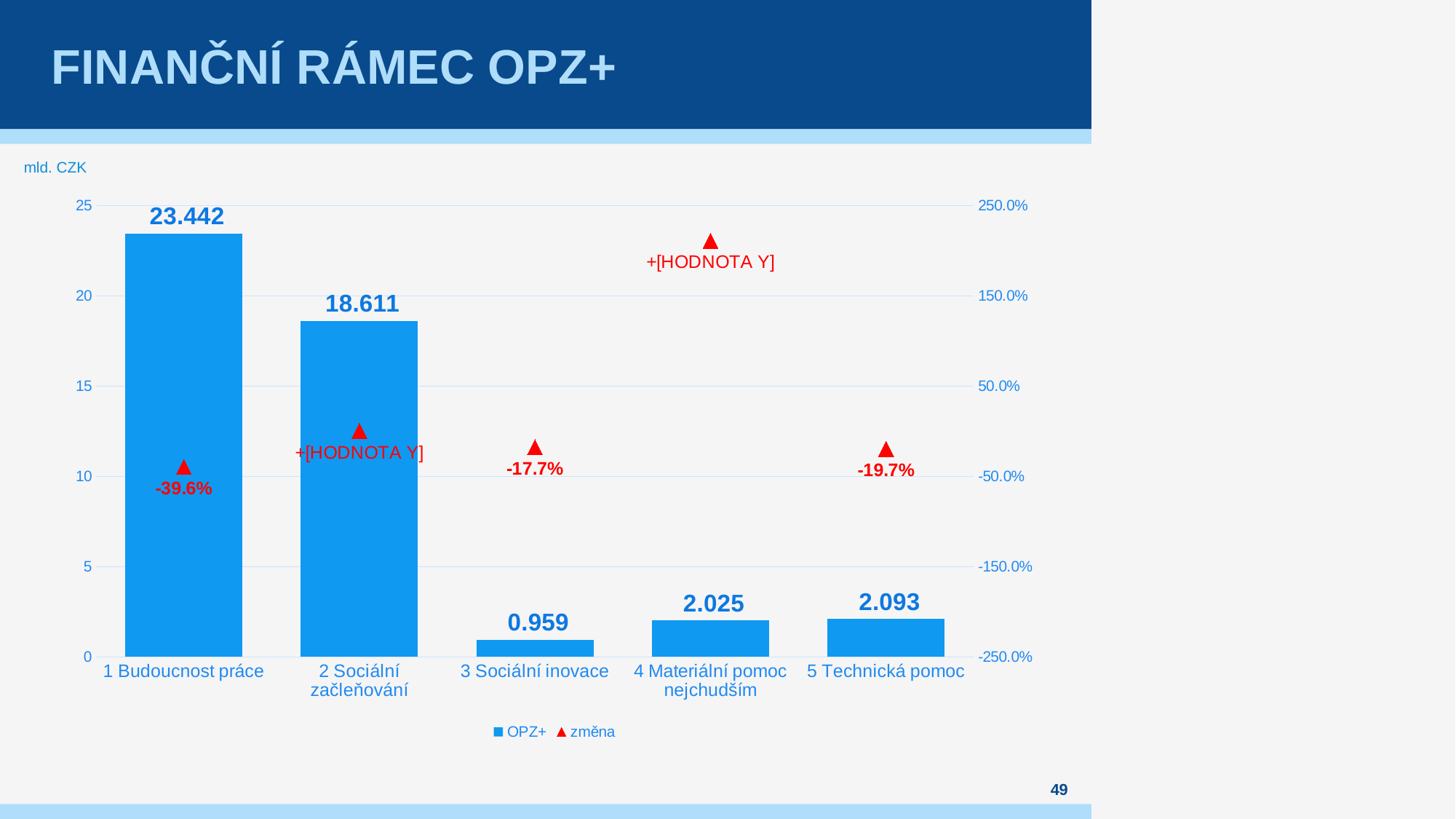
What is the OPZ+ value for 1 Budoucnost práce? 23.442 What is the změna value shown for 3 Sociální inovace? -17.7% What is the OPZ+ value for 3 Sociální inovace? 0.959 How many series does the legend list? 2 Which category has the highest OPZ+ value? 1 Budoucnost práce What is the OPZ+ value for 2 Sociální začleňování? 18.611 Which has a larger OPZ+ value, 4 Materiální pomoc nejchudším or 3 Sociální inovace? 4 Materiální pomoc nejchudším What is the změna value shown for 1 Budoucnost práce? -39.6% Which category has the lowest OPZ+ value? 3 Sociální inovace What is the difference between the OPZ+ values for 1 Budoucnost práce and 2 Sociální začleňování? 4.831 What is the OPZ+ value for 5 Technická pomoc? 2.093 How many categories are shown on the x axis? 5